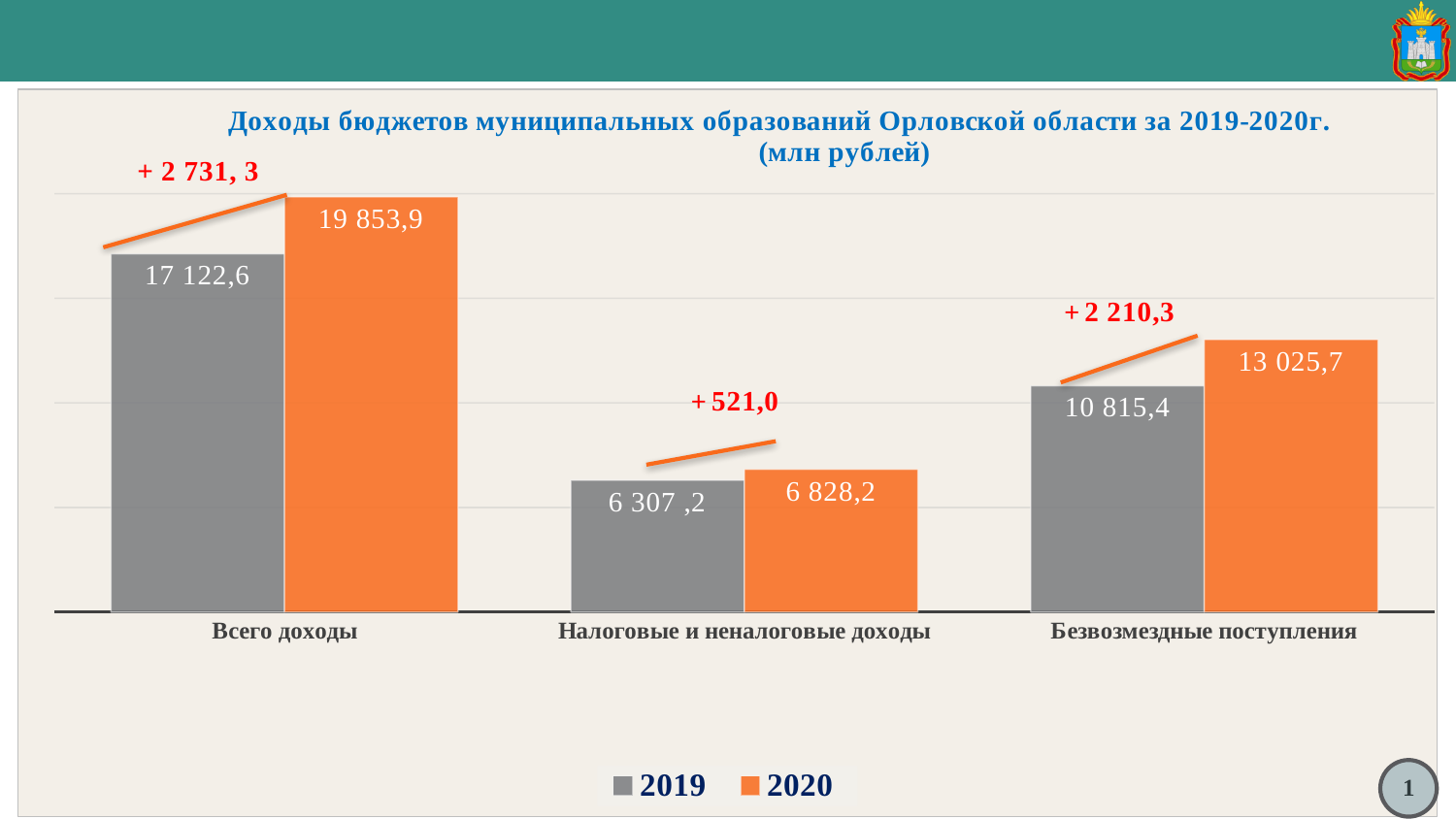
What kind of chart is shown on the slide? Bar chart What is the value for 2020 in the "Всего доходы" category? 19 853,9 How many categories are shown on the x axis? 3 What is the value for 2019 in the "Всего доходы" category? 17 122,6 What is the value for 2020 in the "Безвозмездные поступления" category? 13 025,7 What is the difference between the 2020 and 2019 values for "Безвозмездные поступления"? 2 210,3 Which is larger in the "Налоговые и неналоговые доходы" category: the 2019 value or the 2020 value? 2020 Which category has the lowest value for 2019? Налоговые и неналоговые доходы What is the difference between the 2020 and 2019 values for "Всего доходы"? 2 731,3 Which category has the highest value for 2020? Всего доходы How many series does the legend list? 2 What is the value for 2019 in the "Налоговые и неналоговые доходы" category? 6 307,2